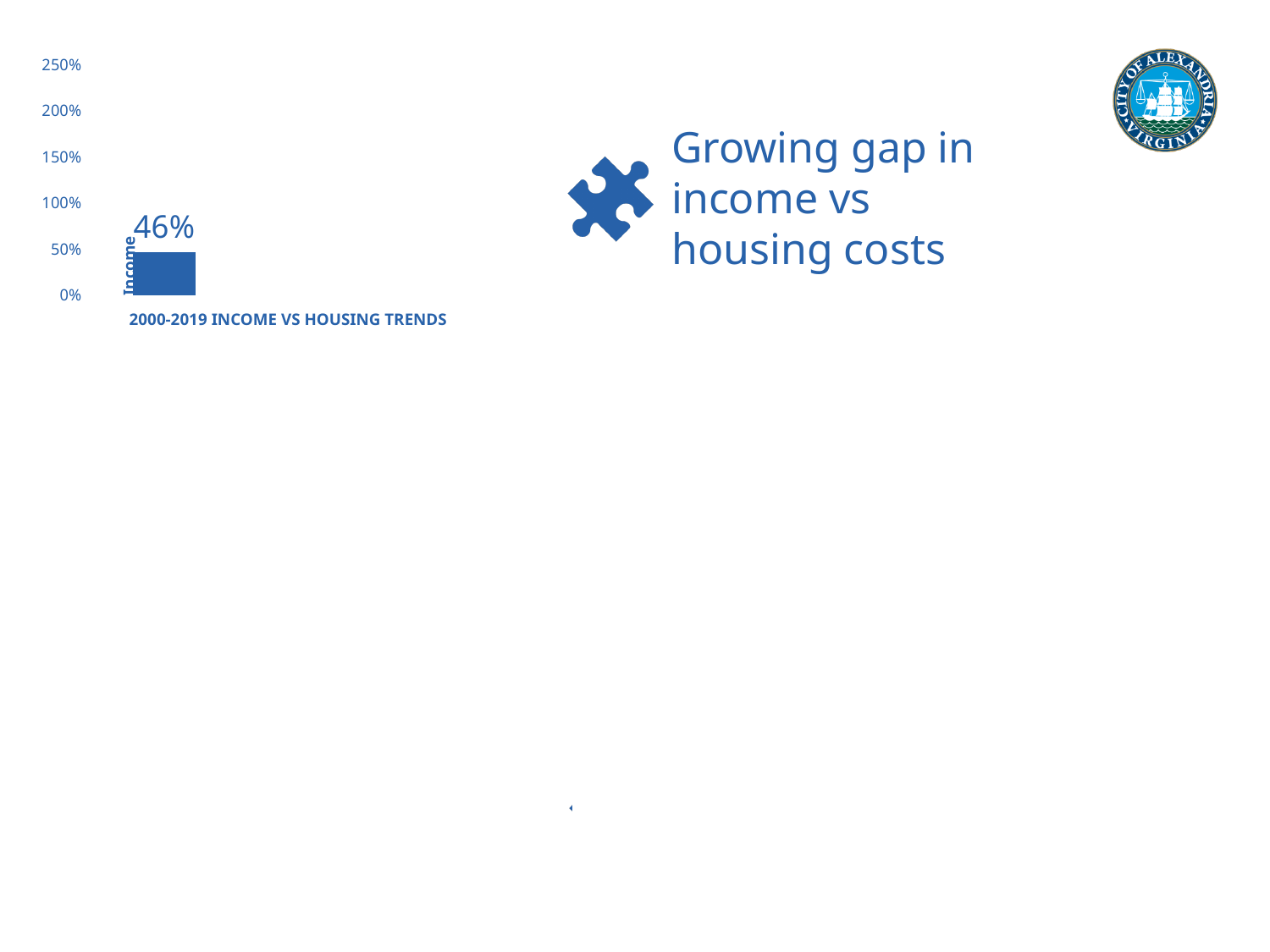
What is the highest value shown on the chart's vertical axis? 250% What is the value shown for Income in the chart? 46% How many bars are plotted in the chart? 1 Is the value for Income greater or less than 100%? less What kind of chart is shown on the slide? bar chart What is the label of the bar shown in the chart? Income What is the title of the chart? 2000-2019 INCOME VS HOUSING TRENDS Is the value for Income greater or less than 50%? less